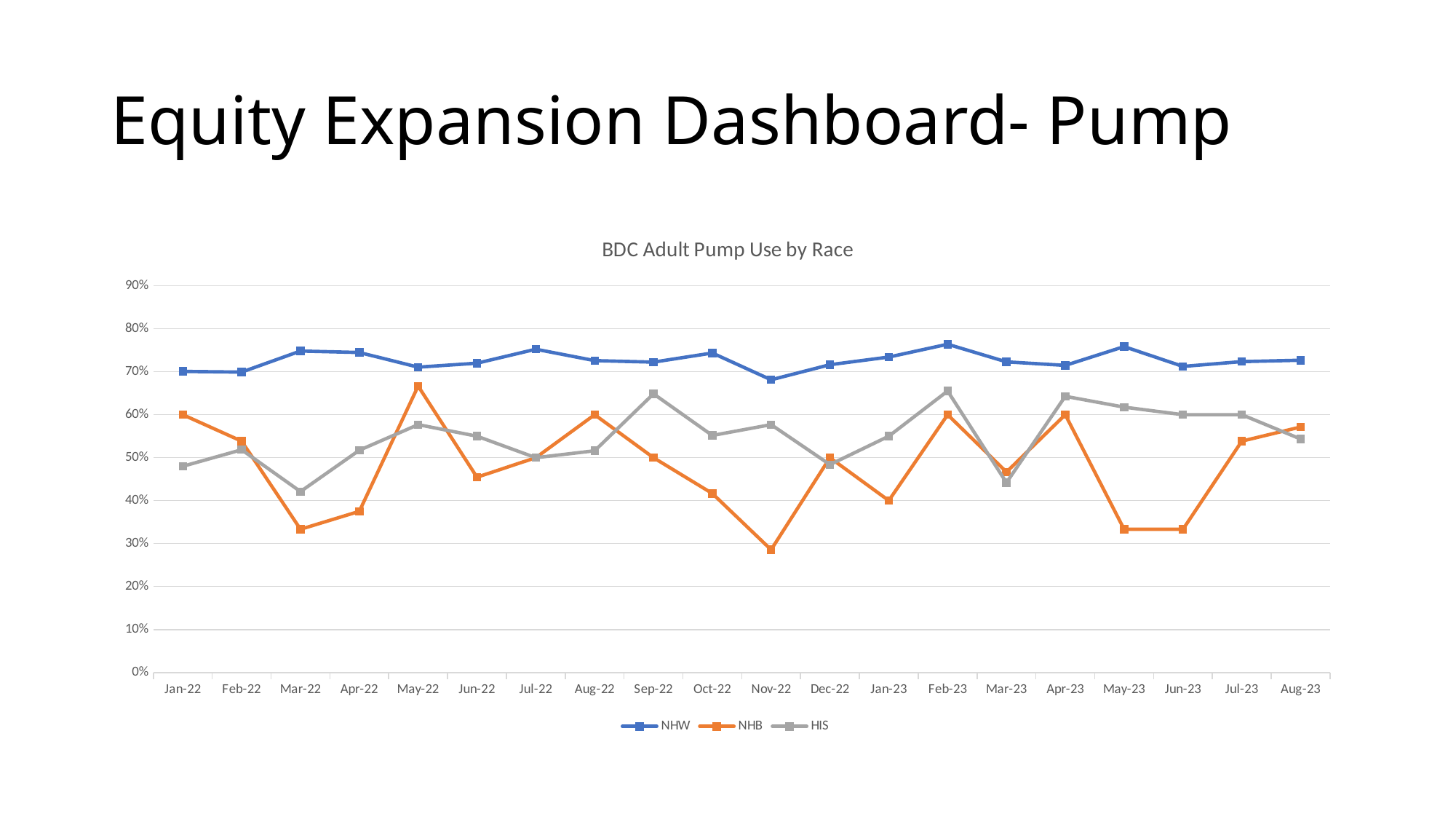
Does the NHB value rise or fall from Apr-23 to May-23? fall Which series is plotted with the orange line? NHB Is the NHB value for Apr-22 greater or less than 40%? less Is the NHW value for Feb-23 greater or less than 70%? greater Which is larger in Nov-22, the NHB value or the HIS value? HIS What kind of chart is shown on the slide? line chart What is the title of the chart? BDC Adult Pump Use by Race How many series does the legend list? 3 In which month is the NHW value lowest? Nov-22 How many months are plotted along the x axis? 20 In which month is the NHB value lowest? Nov-22 In which month is the NHB value highest? May-22